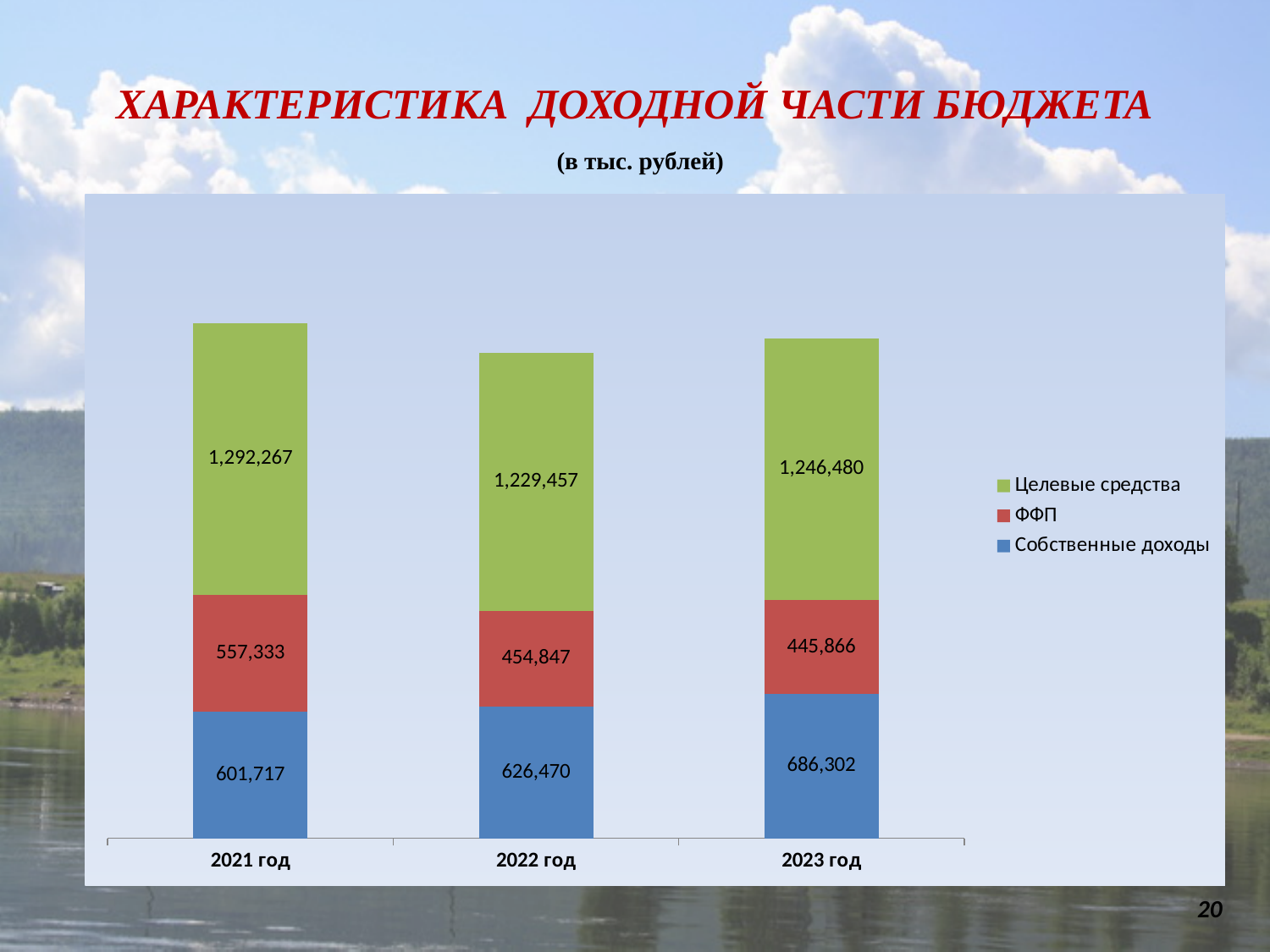
How many series does the legend list? 3 In which year is ФФП the lowest? 2023 год What is the value of Собственные доходы for 2021 год? 601,717 What is the value of ФФП for 2022 год? 454,847 How many years are shown on the x axis? 3 What is the difference between Собственные доходы in 2023 год and in 2021 год? 84,585 What is the value of Целевые средства for 2023 год? 1,246,480 What is the total of the stacked bar for 2022 год? 2,310,774 In which year is Собственные доходы the highest? 2023 год Does ФФП rise or fall from 2021 год to 2023 год? Fall Which is larger: Целевые средства in 2021 год or in 2022 год? 2021 год What kind of chart is shown on the slide? Stacked bar chart